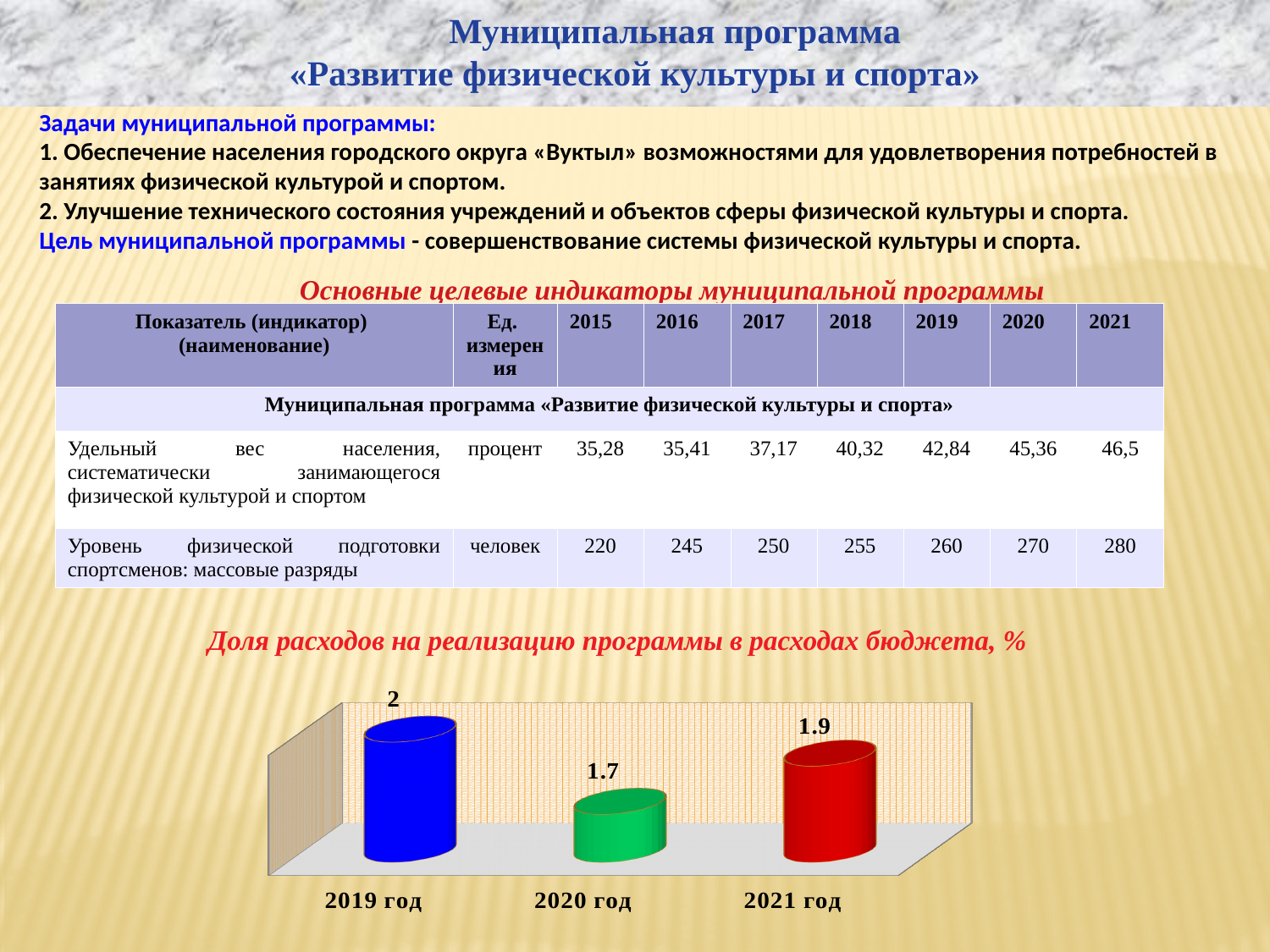
What is the title of the chart? Доля расходов на реализацию программы в расходах бюджета, % What is the value for 2019 год in the chart? 2 What kind of chart is shown on the slide? bar chart Which year has the lowest value in the chart? 2020 год What is the difference between the values for 2021 год and 2020 год? 0.2 How many categories are shown in the chart? 3 Which year has the highest value in the chart? 2019 год Does the value fall or rise from 2019 год to 2020 год? fall What is the difference between the values for 2019 год and 2020 год? 0.3 What is the value for 2021 год in the chart? 1.9 What is the value for 2020 год in the chart? 1.7 Which is larger, the value for 2019 год or the value for 2021 год? 2019 год